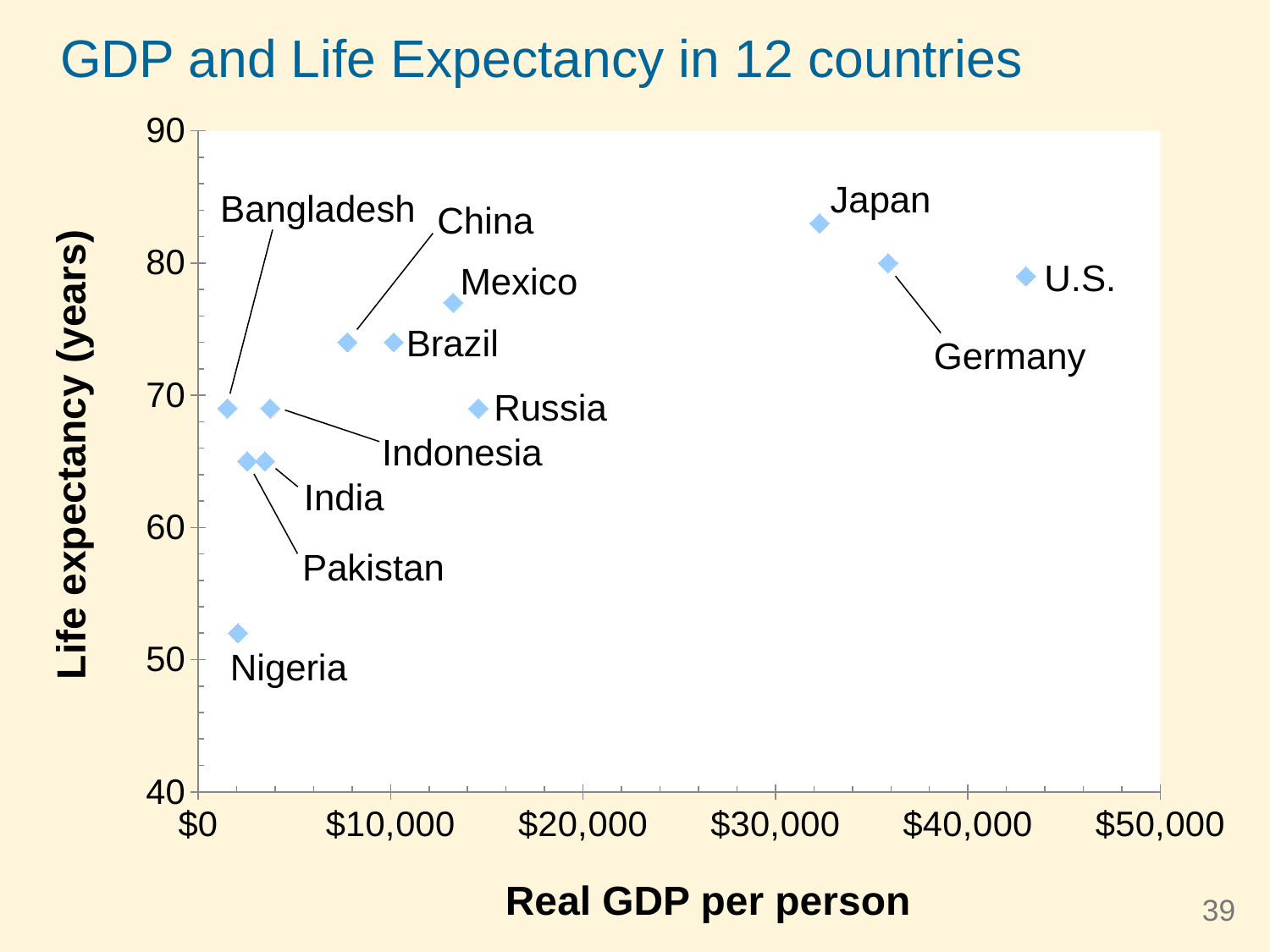
Which country has the highest real GDP per person on the chart? U.S. Which has the higher life expectancy, Japan or the U.S.? Japan Which has the higher life expectancy, Mexico or Russia? Mexico What kind of chart is shown on the slide? scatter plot Which country has the lowest life expectancy on the chart? Nigeria What is the label of the horizontal axis? Real GDP per person How many countries are plotted on the chart? 12 Is the real GDP per person for the U.S. greater or less than $40,000? greater Is the life expectancy for Japan greater or less than 80 years? greater Which country has the highest life expectancy on the chart? Japan Is the real GDP per person for Russia greater or less than $20,000? less